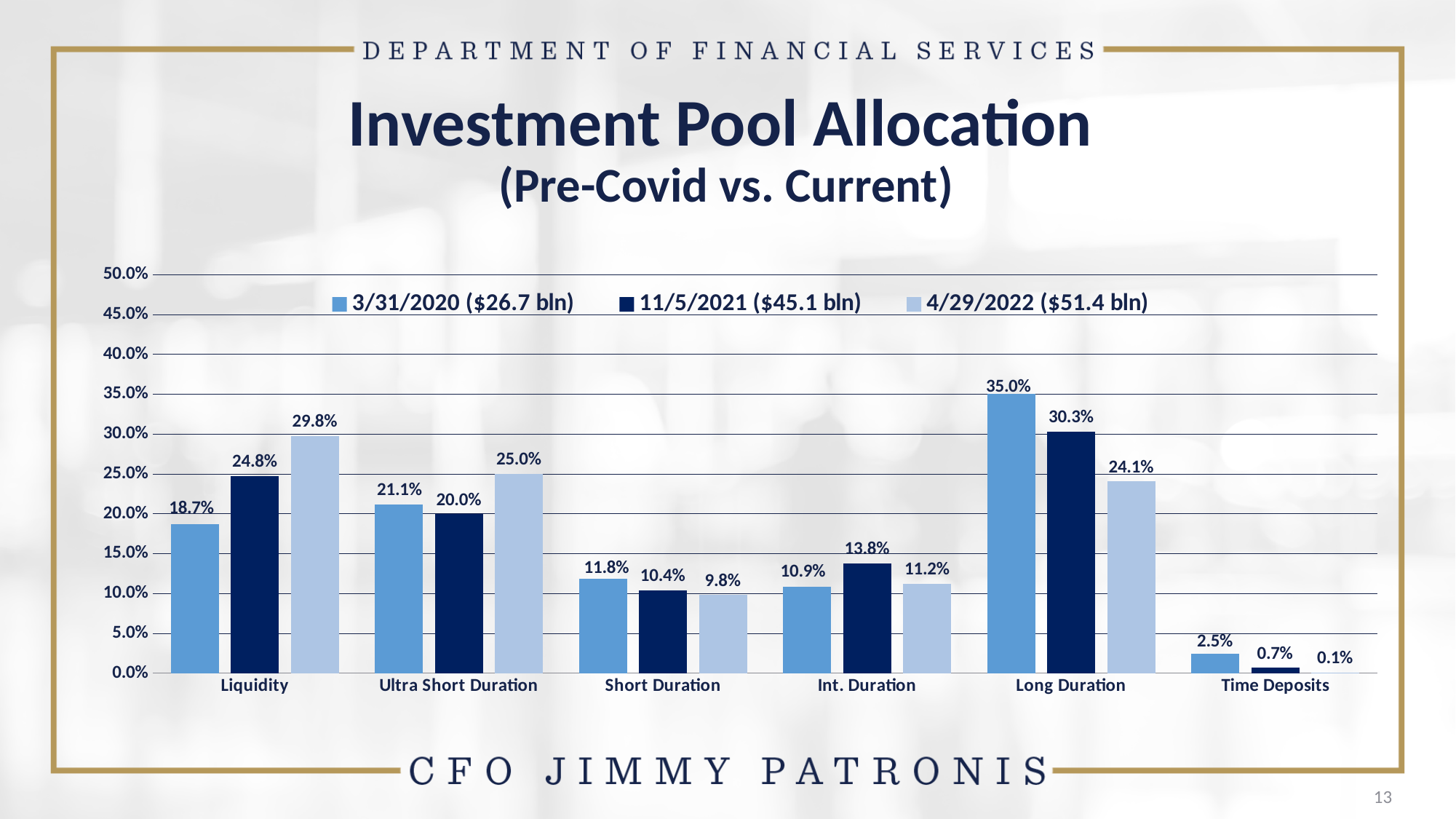
What kind of chart is shown on the slide? bar chart Which is larger for Ultra Short Duration: the 3/31/2020 value or the 11/5/2021 value? 3/31/2020 What is the value for Liquidity in the 4/29/2022 ($51.4 bln) series? 29.8% How many series does the legend list? 3 What is the difference between the 3/31/2020 and 4/29/2022 values for Long Duration? 10.9% Which category has the highest value in the 11/5/2021 ($45.1 bln) series? Long Duration What is the title of the chart on the slide? Investment Pool Allocation (Pre-Covid vs. Current) Do the values for Short Duration rise or fall from the 3/31/2020 series to the 4/29/2022 series? fall Which category has the lowest value in the 4/29/2022 ($51.4 bln) series? Time Deposits How many categories are shown on the x axis? 6 What is the value for Long Duration in the 3/31/2020 ($26.7 bln) series? 35.0% What is the value for Time Deposits in the 11/5/2021 ($45.1 bln) series? 0.7%